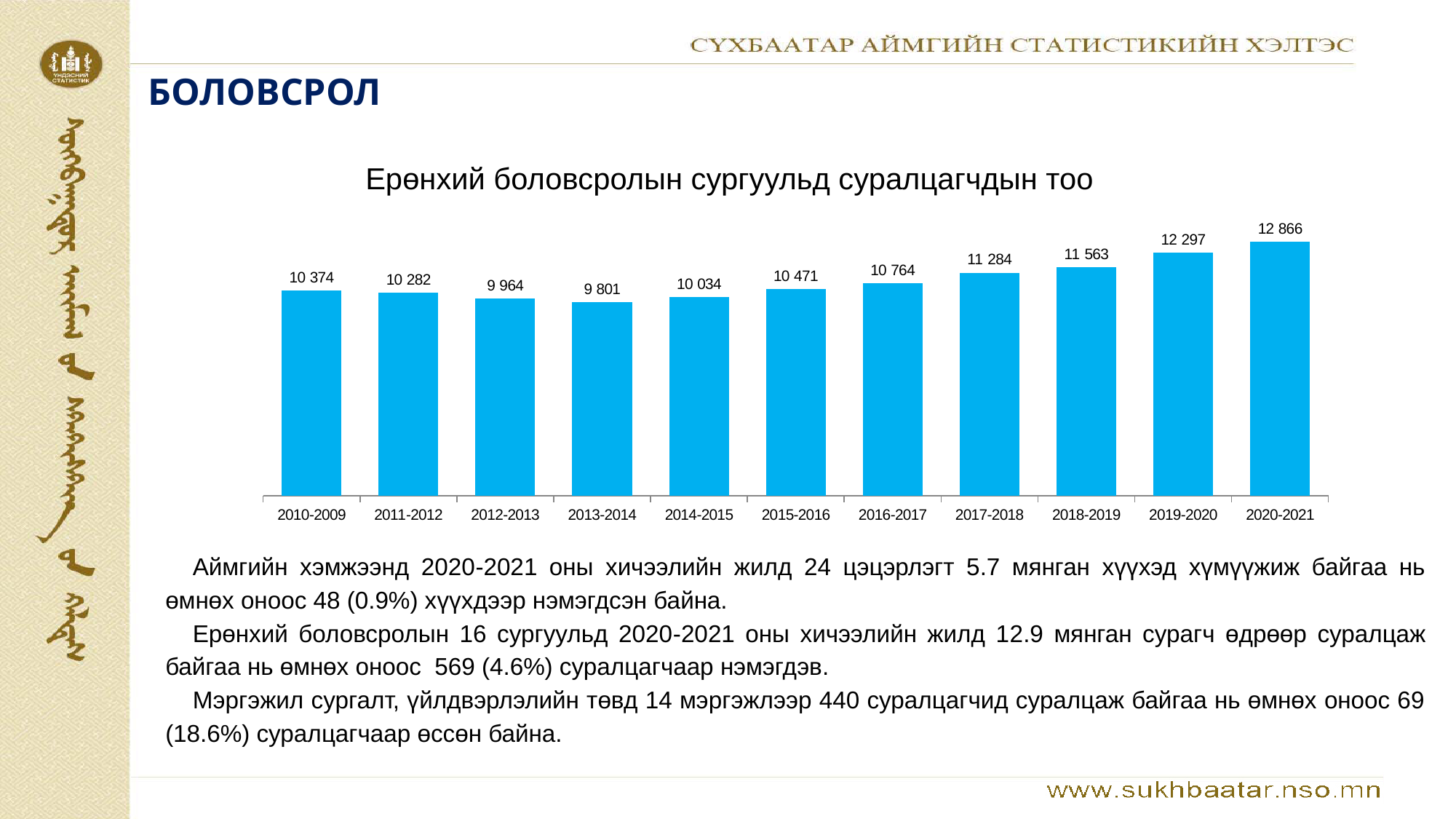
Do the values rise or fall from 2013-2014 to 2020-2021? rise What is the value for 2020-2021? 12 866 What is the value for 2016-2017? 10 764 Which is larger, the value for 2011-2012 or the value for 2015-2016? 2015-2016 What is the difference between the values for 2020-2021 and 2019-2020? 569 Which category has the lowest value? 2013-2014 What is the value for 2013-2014? 9 801 How many categories are shown on the x axis? 11 What kind of chart is this? bar chart Which category has the highest value? 2020-2021 What is the difference between the values for 2010-2009 and 2013-2014? 573 What is the title of the chart? Ерөнхий боловсролын сургуульд суралцагчдын тоо